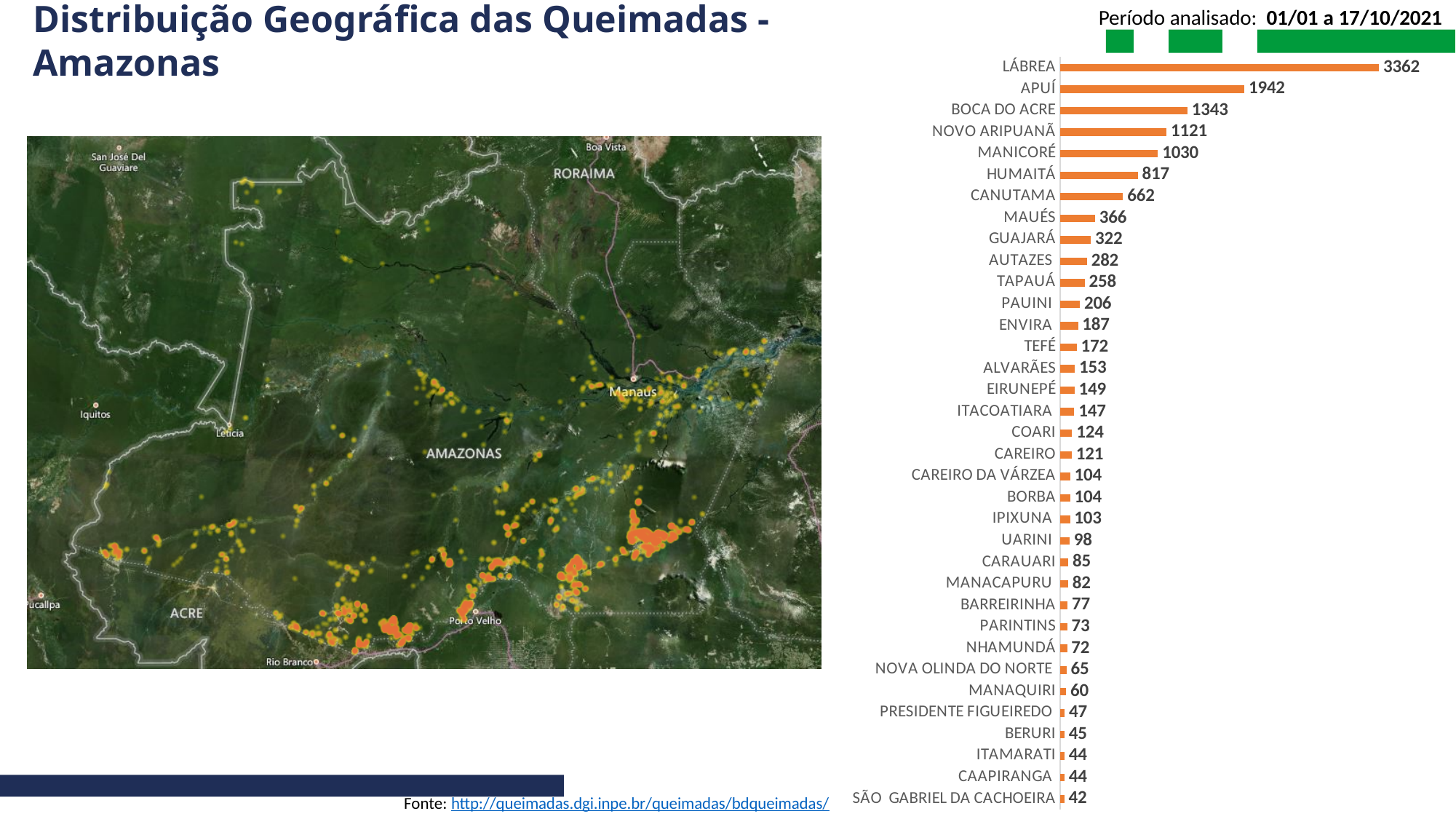
How many fire hotspots are shown for LÁBREA? 3362 What period is analysed according to the text above the chart? 01/01 a 17/10/2021 What kind of chart is shown on the right side of the slide? Bar chart What is the value shown for HUMAITÁ? 817 Which municipality has the highest value in the bar chart? LÁBREA Which has a larger value, BOCA DO ACRE or NOVO ARIPUANÃ? BOCA DO ACRE What is the difference between the values for LÁBREA and APUÍ? 1420 What is the difference between the values for MANICORÉ and HUMAITÁ? 213 How many municipalities are listed in the bar chart? 35 Which municipality has the lowest value in the bar chart? SÃO GABRIEL DA CACHOEIRA What is the value shown for TEFÉ? 172 Which has a larger value, MAUÉS or CANUTAMA? CANUTAMA